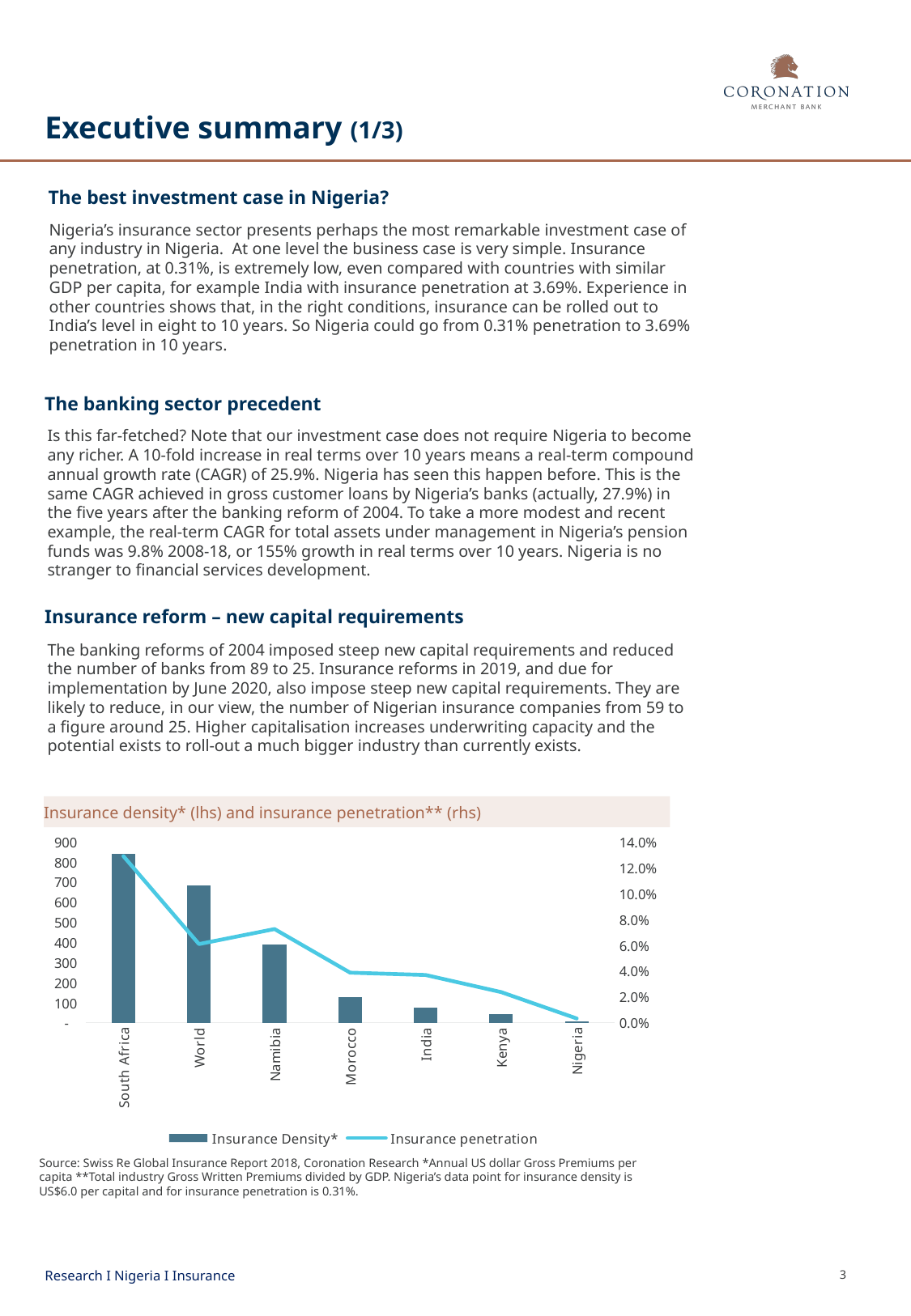
Do the Insurance Density bars rise or fall moving from left to right along the x axis? fall Is the insurance penetration value for Namibia greater or less than 6.0%? greater Which category has the lowest Insurance Density bar? Nigeria What is the title of the chart? Insurance density* (lhs) and insurance penetration** (rhs) Which category has the highest insurance penetration on the line? South Africa What kind of chart is shown on the slide? A combination bar and line chart How many countries/regions are shown on the x axis of the chart? 7 Which category has the highest Insurance Density bar? South Africa How many series does the chart legend list? 2 Is the Insurance Density value for Morocco greater or less than 200? less Is the Insurance Density value for South Africa greater or less than 800? greater Which has the higher insurance penetration, Namibia or World? Namibia